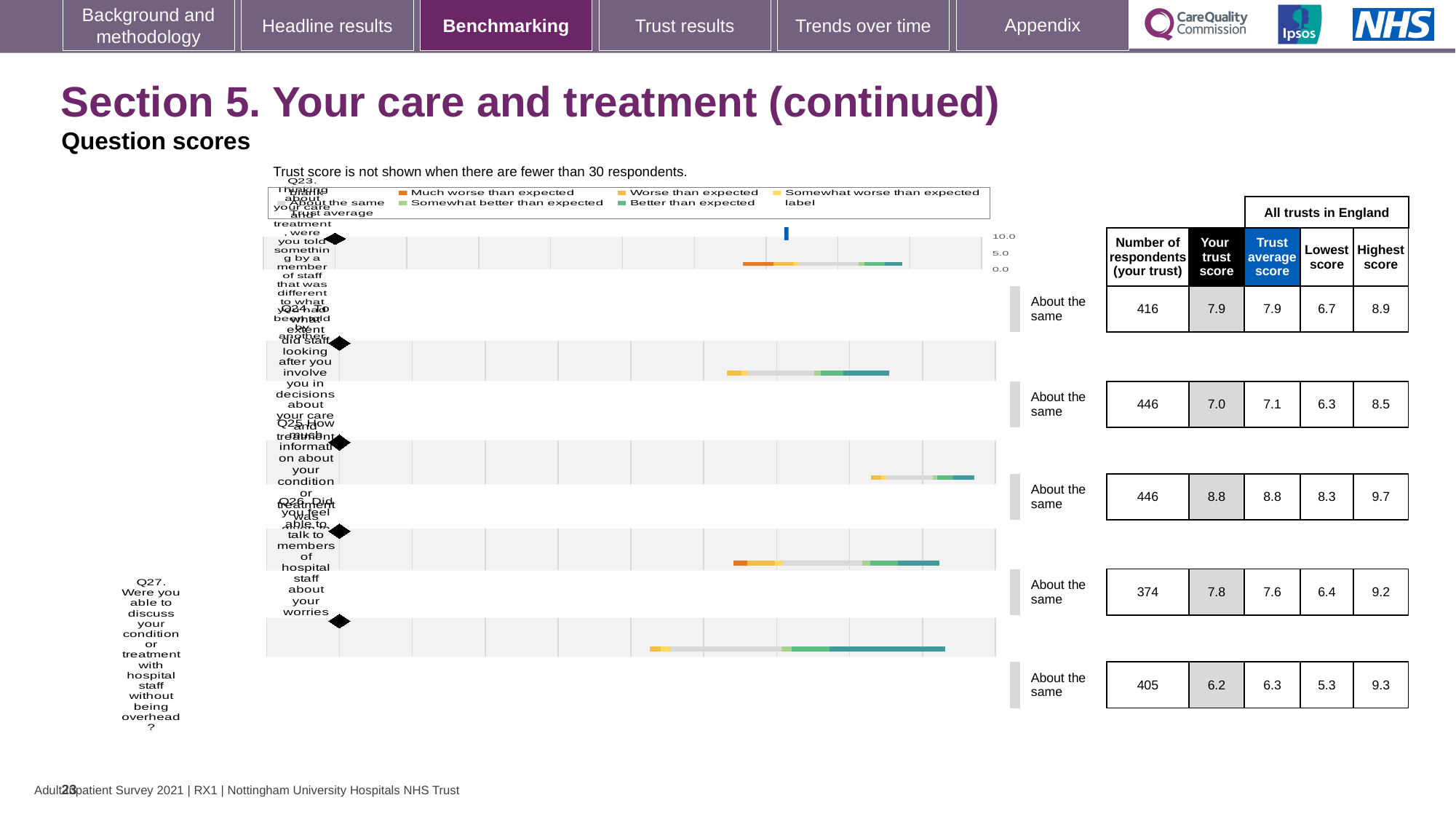
In the table next to the chart, what is the number of respondents in the first (top) row? 416 In the table next to the chart, what is the 'Your trust score' for Q27 (discussing your condition or treatment without being overheard)? 6.2 In the table next to the chart, what is the 'Your trust score' in the first (top) row? 7.9 How many question rows are shown in the benchmarking chart and table on this slide? 5 In the table next to the chart, which row has the highest 'Your trust score'? The third row (8.8) In the table next to the chart, which row has the lowest 'Your trust score'? The last row, Q27 (6.2) In the table next to the chart, what is the 'Lowest score' for Q27 (discussing your condition or treatment without being overheard)? 5.3 For Q27, what is the difference between the 'Highest score' and the 'Lowest score' in the table? 4.0 In the table next to the chart, what is the number of respondents for Q27 (discussing your condition or treatment without being overheard)? 405 In the table next to the chart, what is the 'Highest score' for Q27 (discussing your condition or treatment without being overheard)? 9.3 What benchmark category label is shown beside each question row on this slide? About the same For Q27, is the 'Your trust score' larger or smaller than the 'Trust average score'? Smaller